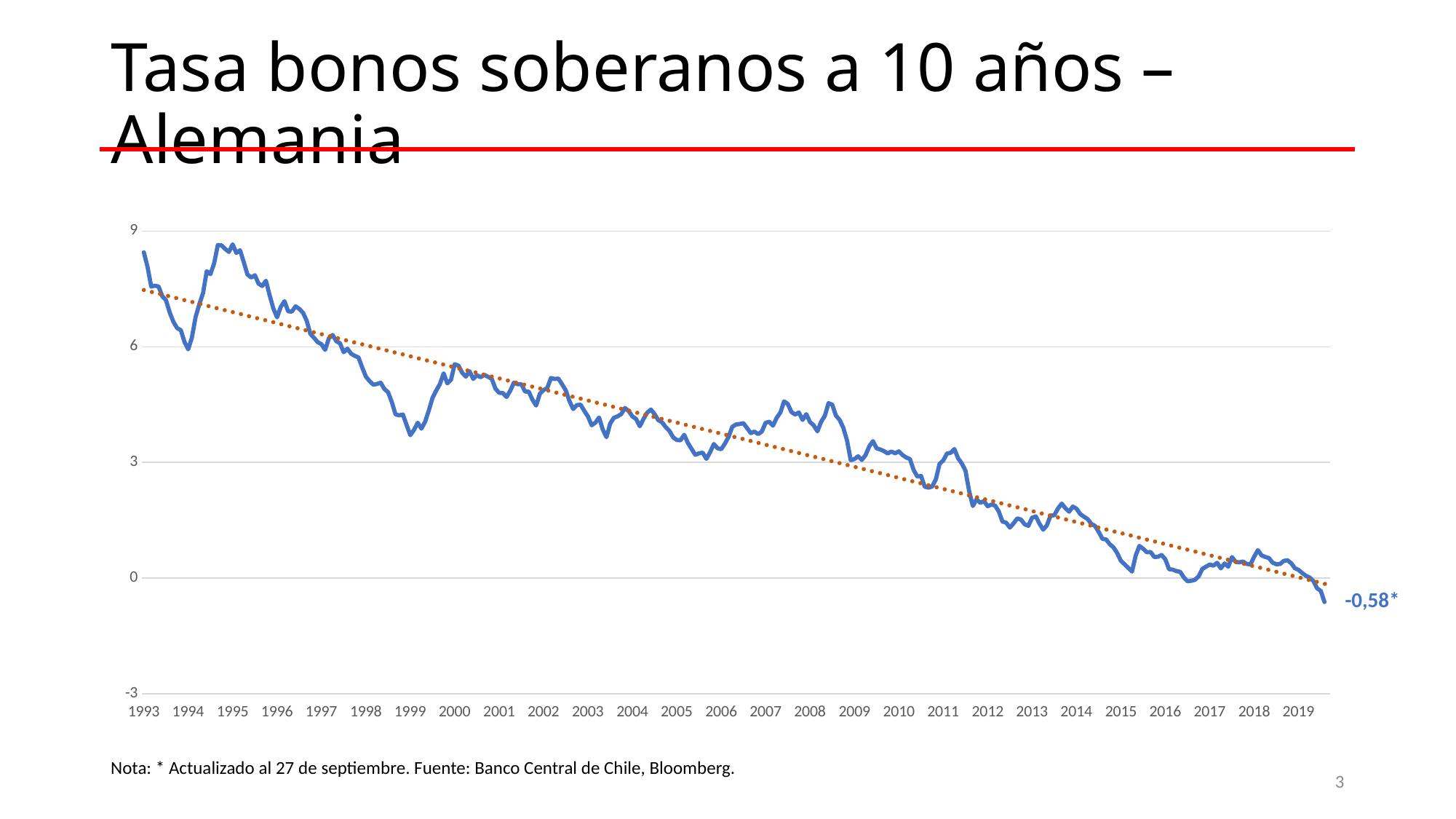
Is the value in 2000 greater or less than 3? greater What is the title of the slide containing the chart? Tasa bonos soberanos a 10 años – Alemania Do the values generally rise or fall from 1993 to 2019? fall What is the value printed at the end of the line, for the latest data point in 2019? -0,58 In which year does the line reach its lowest point? 2019 What is the highest value shown on the y axis? 9 Is the value in 2005 greater or less than 6? less Is the value in 2016 greater or less than 3? less Which is larger, the value in 1995 or the value in 2019? 1995 How many years are labelled on the x axis? 27 What kind of chart is shown on the slide? line chart